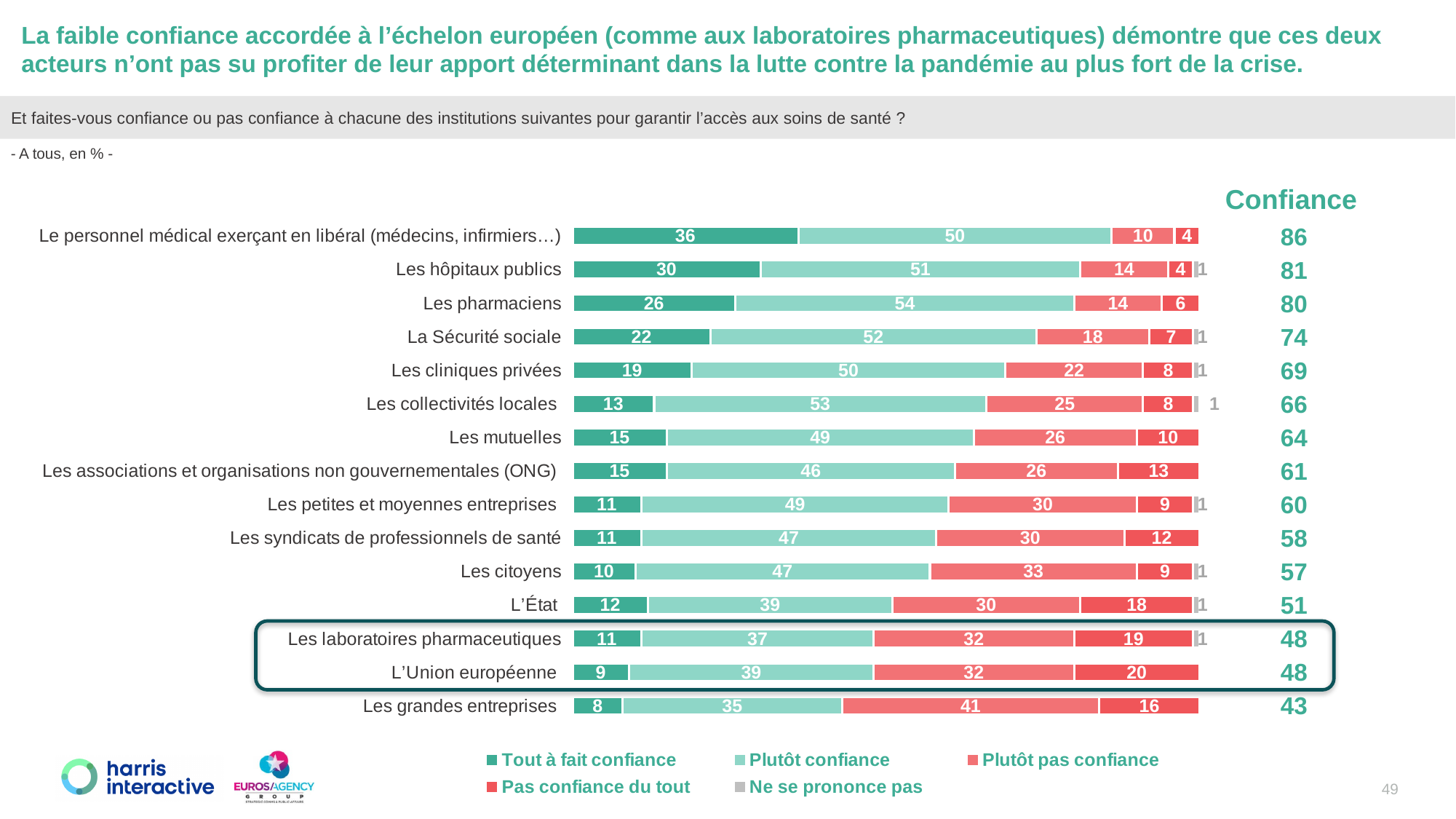
Which category has the lowest "Confiance" score? Les grandes entreprises Which category has the highest "Tout à fait confiance" value? Le personnel médical exerçant en libéral (médecins, infirmiers…) Which has a larger "Pas confiance du tout" value: "L'État" or "Les grandes entreprises"? L'État Which two categories are highlighted with a box on the chart? Les laboratoires pharmaceutiques and L'Union européenne How many institutions (categories) are shown in the chart? 15 What is the "Tout à fait confiance" value for "Le personnel médical exerçant en libéral (médecins, infirmiers…)"? 36 What is the difference between the "Plutôt confiance" values for "Les pharmaciens" and "Les hôpitaux publics"? 3 What is the total of the "Tout à fait confiance" and "Plutôt confiance" segments for "Les mutuelles"? 64 What kind of chart is shown on the slide? Stacked bar chart How many series does the legend list? 5 What is the "Confiance" score shown for "L'État"? 51 What is the "Plutôt pas confiance" value for "Les grandes entreprises"? 41